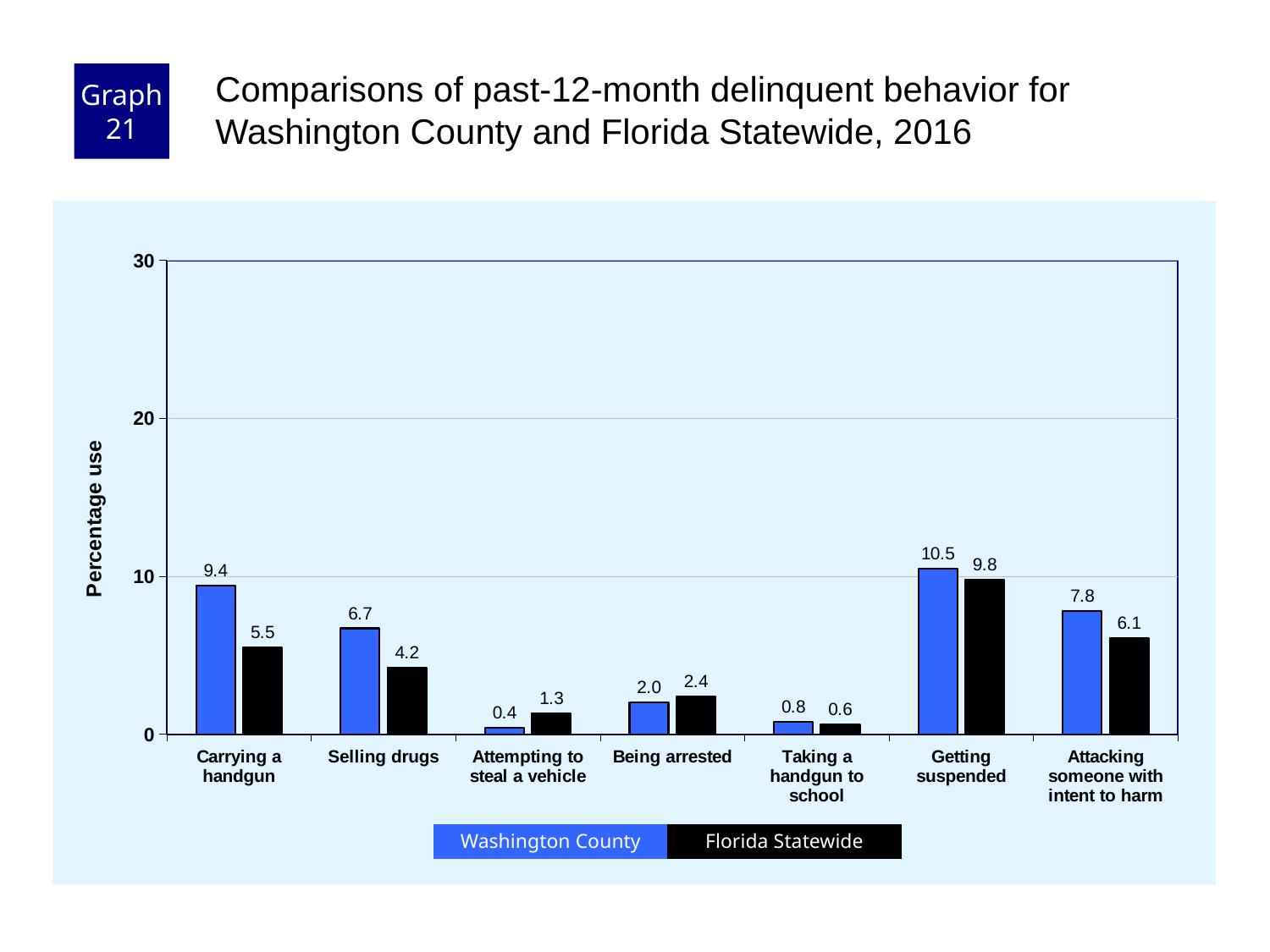
Which category has the lowest Florida Statewide value? Taking a handgun to school What is the Florida Statewide value for Getting suspended? 9.8 How many categories are shown on the x axis? 7 Which category has the highest Washington County value? Getting suspended What kind of chart is shown on the slide? bar chart Is the Washington County value for Getting suspended greater or less than 10? greater What is the label of the y axis? Percentage use What is the Washington County value for Carrying a handgun? 9.4 How many series does the legend list? 2 What is the difference between the Washington County and Florida Statewide values for Selling drugs? 2.5 For Being arrested, which is larger: Washington County or Florida Statewide? Florida Statewide What is the Washington County value for Attempting to steal a vehicle? 0.4